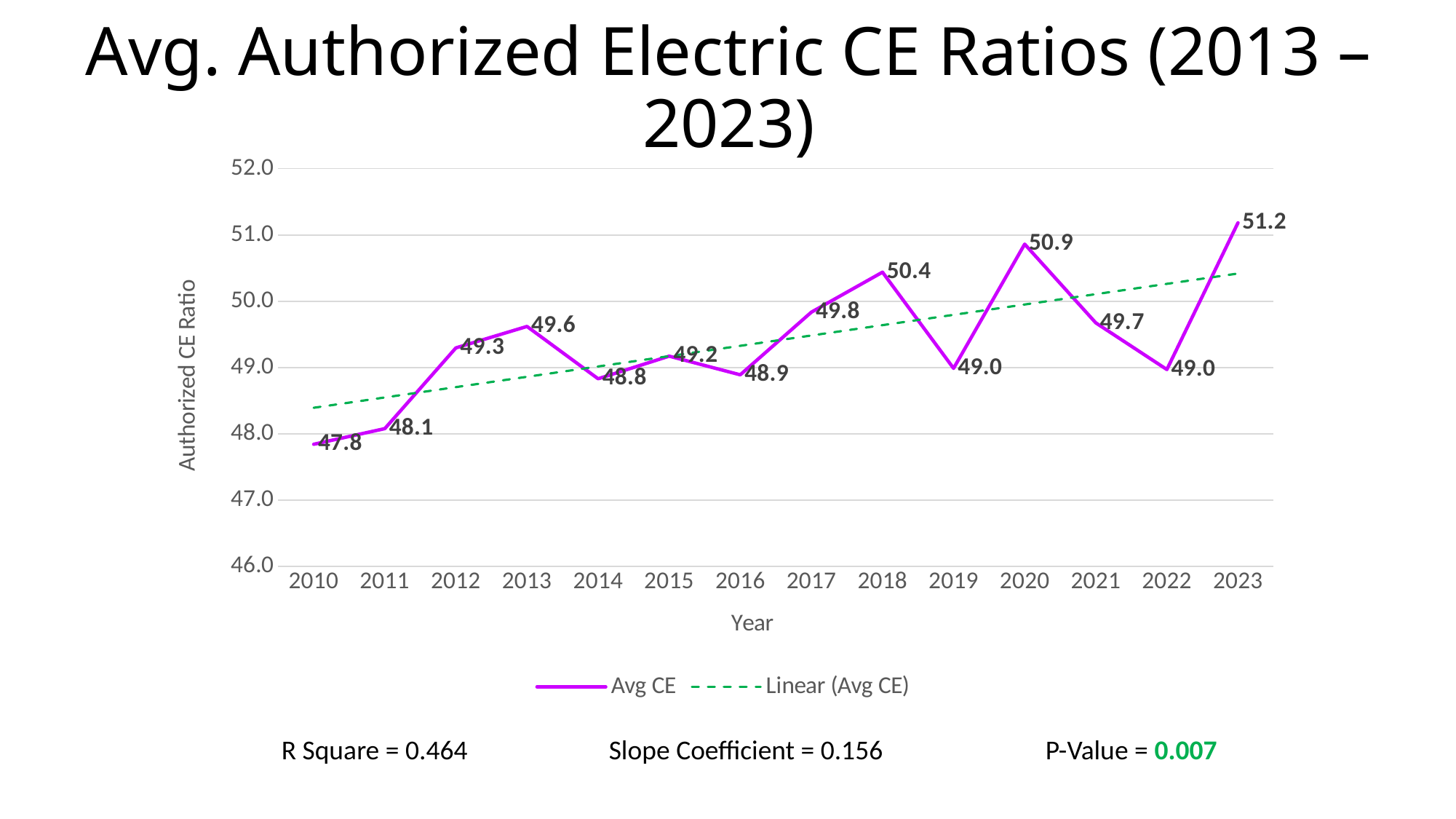
How many series does the legend list? 2 What is the label of the y axis? Authorized CE Ratio What is the difference between the Avg CE values for 2023 and 2010? 3.4 What is the Avg CE value for 2021? 49.7 What is the Avg CE value for 2018? 50.4 Which year has the highest Avg CE value? 2023 Which year has the lowest Avg CE value? 2010 Which year has a larger Avg CE value, 2020 or 2018? 2020 Does the dashed Linear (Avg CE) trend line rise or fall from 2010 to 2023? rise How many years are plotted on the x axis? 14 What kind of chart is shown on the slide? line chart What is the Avg CE value for 2010? 47.8